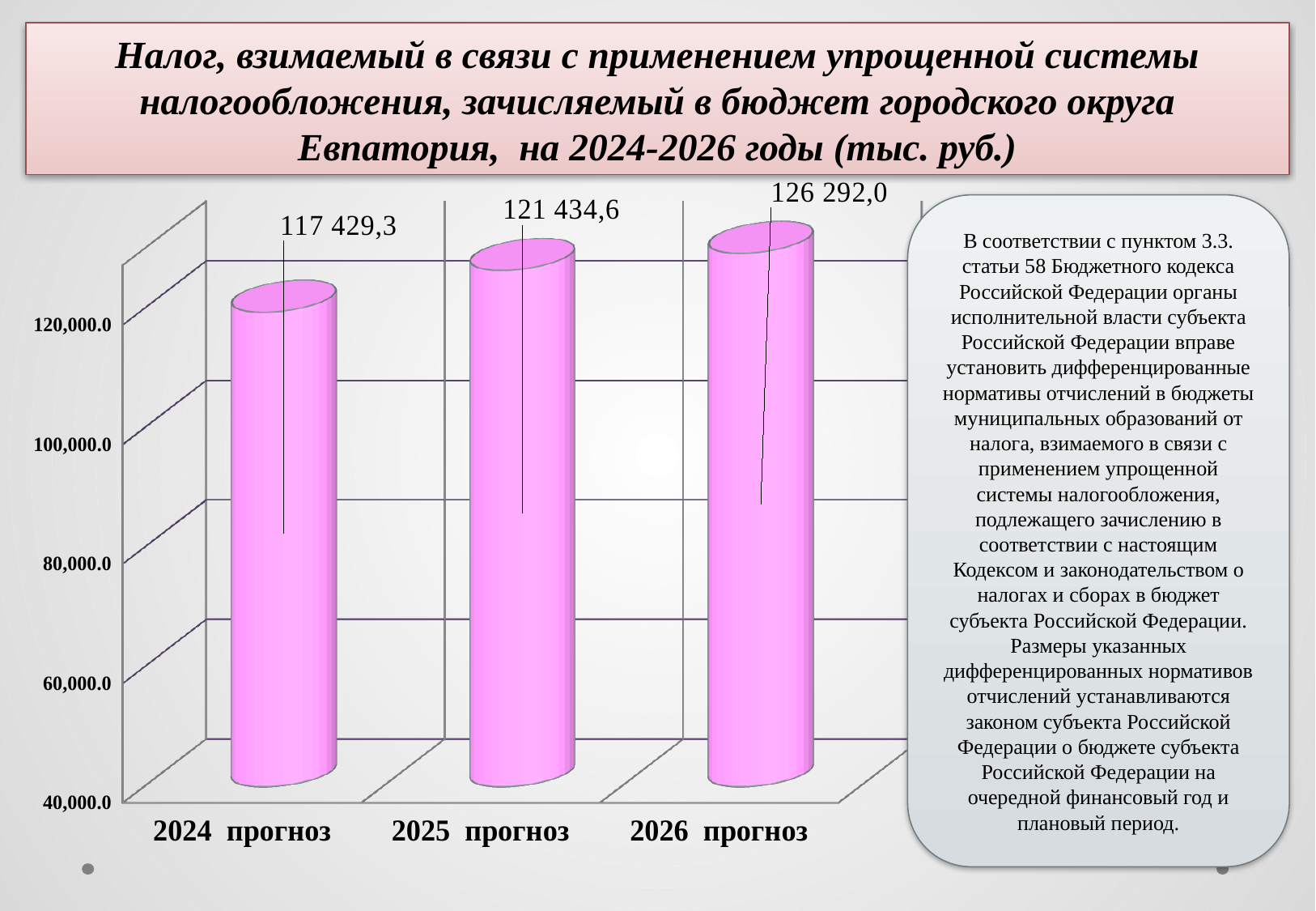
Is the value for 2024 прогноз greater or less than 100,000.0? greater Which category has the lowest value? 2024 прогноз What is the value for 2026 прогноз? 126 292,0 What kind of chart is shown on the slide? bar chart Which is larger, the value for 2024 прогноз or the value for 2026 прогноз? 2026 прогноз What is the value for 2024 прогноз? 117 429,3 What is the difference between the values for 2025 прогноз and 2024 прогноз? 4 005,3 Do the values rise or fall from 2024 прогноз to 2026 прогноз? rise Which category has the highest value? 2026 прогноз What is the value for 2025 прогноз? 121 434,6 How many categories are shown on the chart? 3 What is the difference between the values for 2026 прогноз and 2025 прогноз? 4 857,4